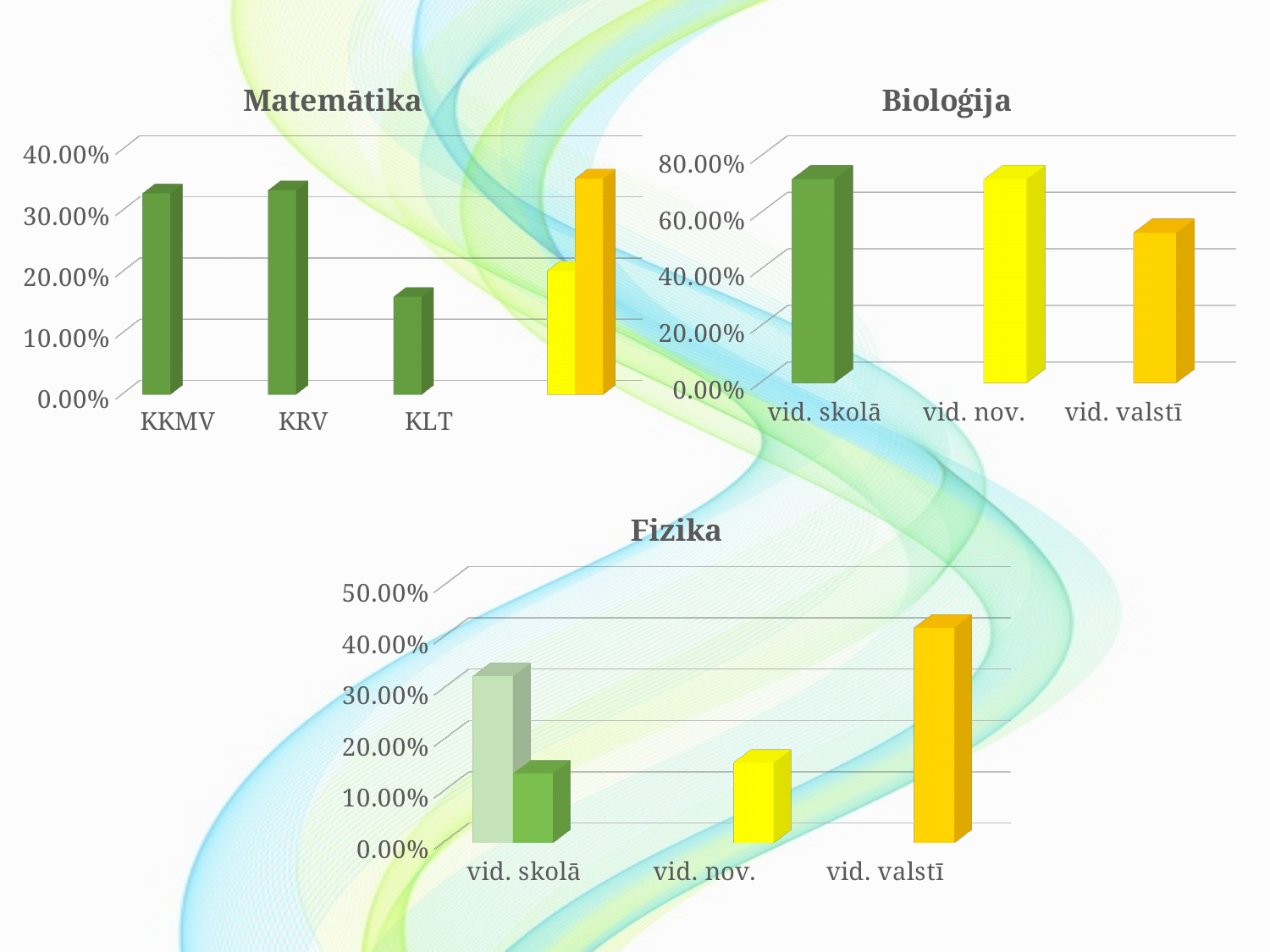
In the Bioloģija chart, which category has the lowest value? vid. valstī In the Fizika chart, which category has the highest value? vid. valstī How many categories are shown on the x axis of the Bioloģija chart? 3 In the Matemātika chart, is the value for KKMV greater or less than 30.00%? greater In the Matemātika chart, is the value for KLT greater or less than 20.00%? less In the Fizika chart, is the value for vid. valstī greater or less than 40.00%? greater What kind of chart is the Matemātika chart? bar chart In the Matemātika chart, which of the labelled categories has the lowest value? KLT In the Matemātika chart, which is larger, the value for KRV or the value for KLT? KRV